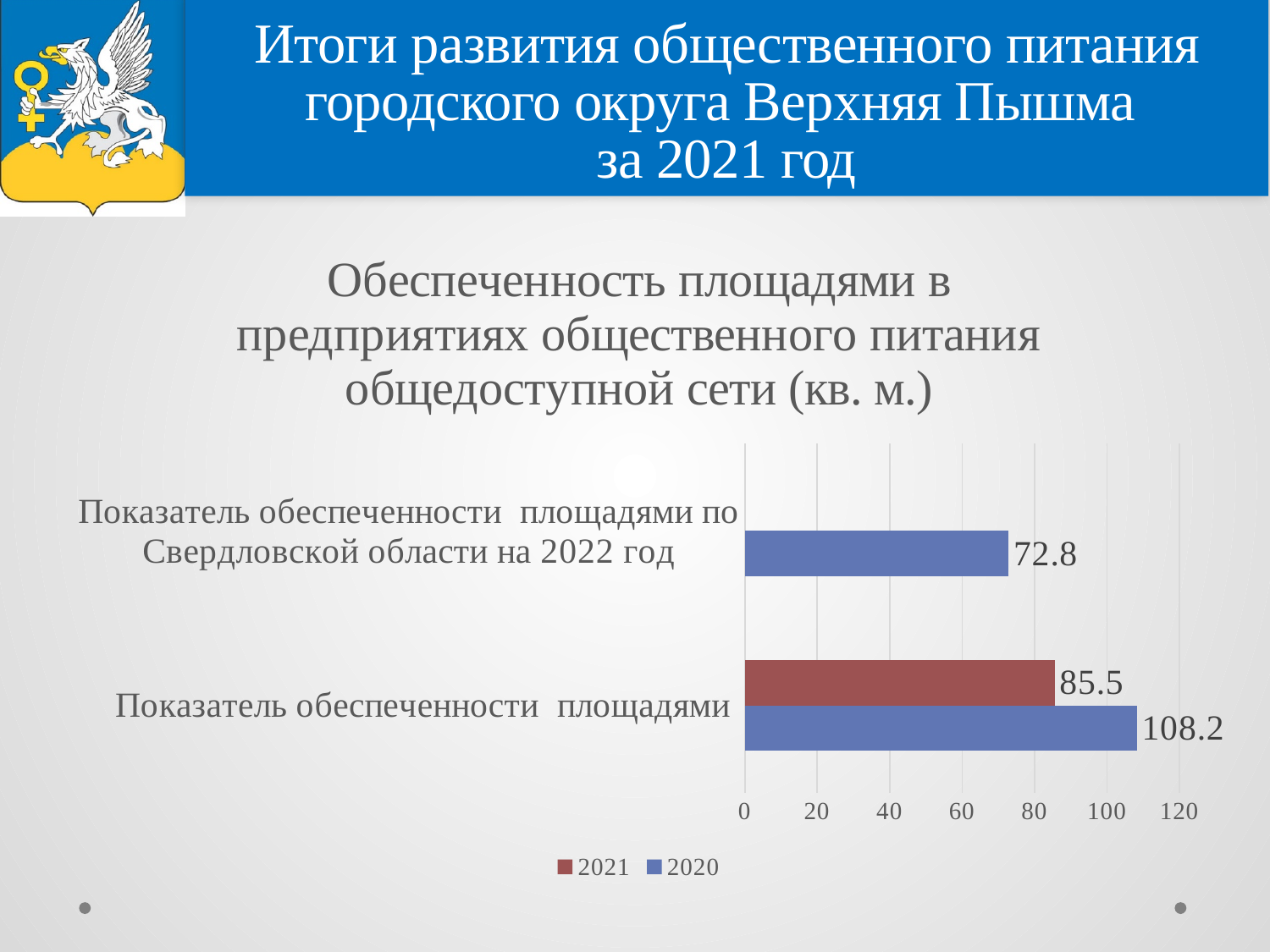
What is the difference between the 2020 and 2021 values for "Показатель обеспеченности площадями"? 22.7 Which is larger for "Показатель обеспеченности площадями": the 2021 value or the 2020 value? 2020 How many categories are shown on the vertical axis of the chart? 2 What type of chart is shown on the slide? bar chart Which bar in the chart has the highest value? 2020 value for "Показатель обеспеченности площадями" (108.2) Which bar in the chart has the lowest value? "Показатель обеспеченности площадями по Свердловской области на 2022 год" (72.8) What is the 2020 value for "Показатель обеспеченности площадями"? 108.2 What is the 2021 value for "Показатель обеспеченности площадями"? 85.5 What is the difference between the 2020 value for "Показатель обеспеченности площадями" and the value for "Показатель обеспеченности площадями по Свердловской области на 2022 год"? 35.4 What is the value shown for "Показатель обеспеченности площадями по Свердловской области на 2022 год"? 72.8 What colour represents the 2021 series in the chart? red How many series does the legend list? 2